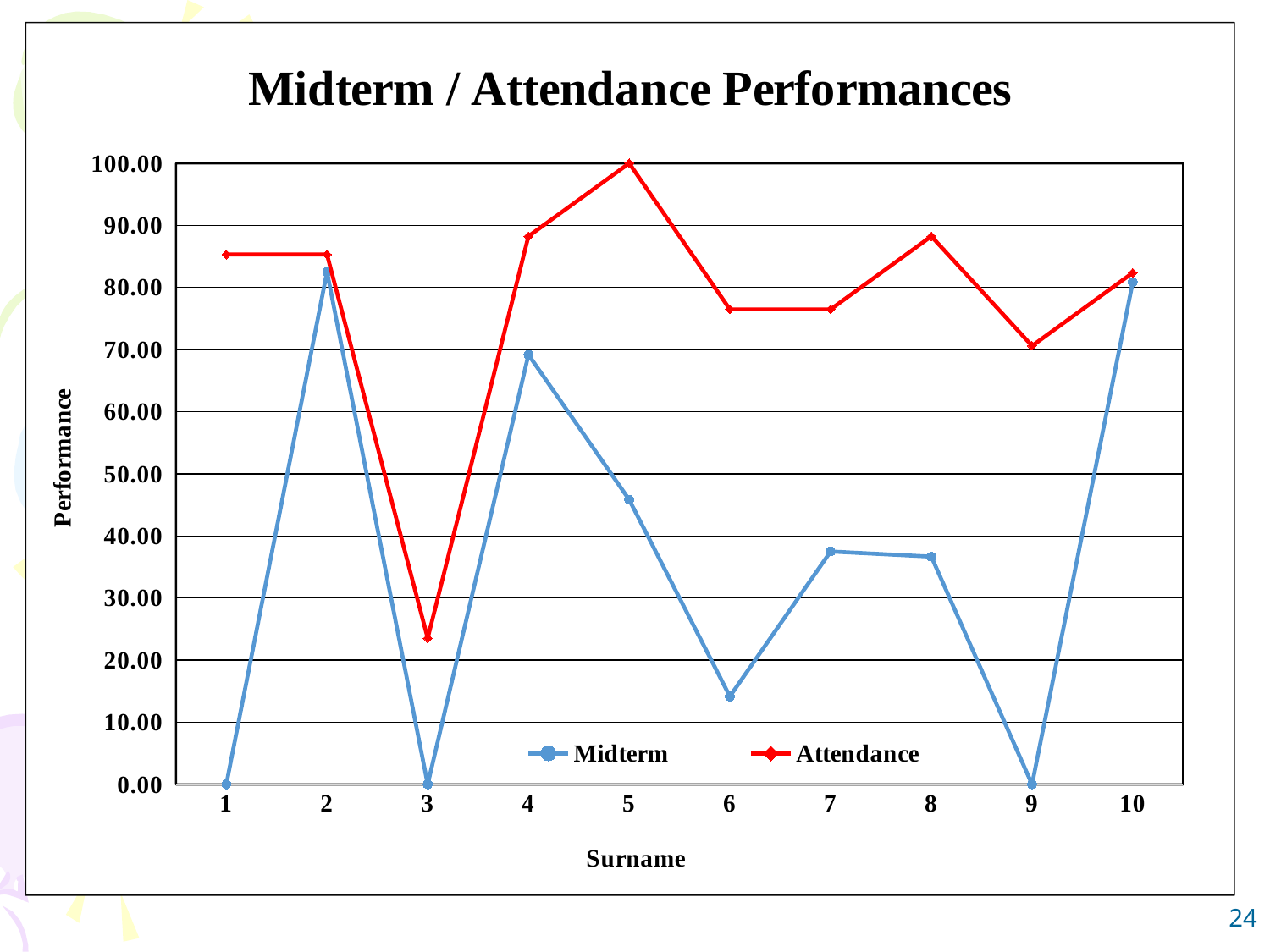
How many surnames (categories) are plotted along the x axis? 10 What is the Attendance value for surname 5? 100.00 What is the title of the x axis? Surname For surname 5, which is larger, the Midterm value or the Attendance value? Attendance What is the Midterm value for surname 1? 0.00 Which surname has the highest Attendance value? 5 What type of chart is shown on the slide? line chart Does the Midterm line rise or fall from surname 4 to surname 6? fall Is the Attendance value for surname 3 greater or less than 30.00? less How many series does the legend list? 2 Is the Midterm value for surname 6 greater or less than 20.00? less Which surname has the lowest Attendance value? 3